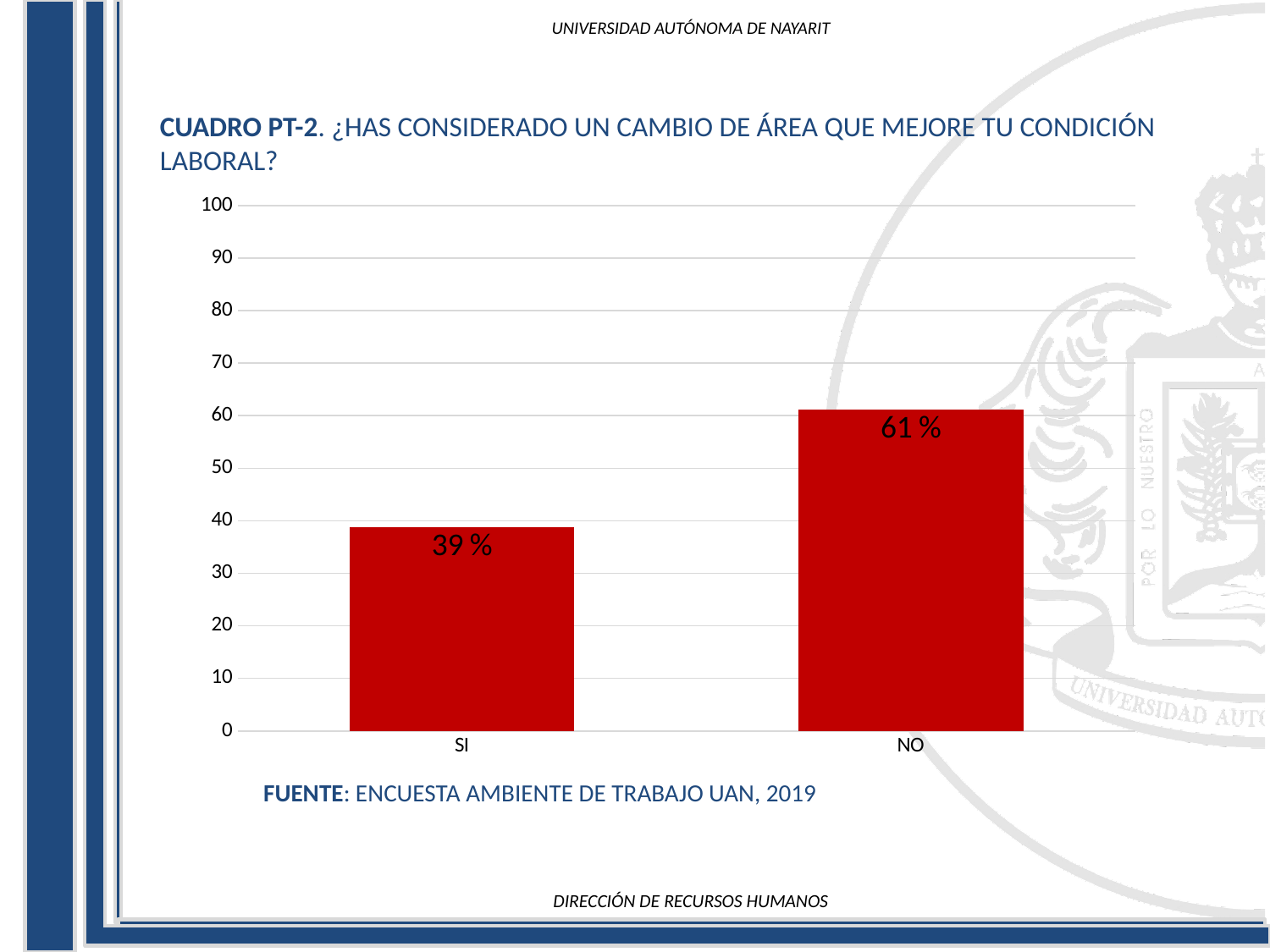
What is the difference between the values for NO and SI? 22 % What is the value for NO? 61 % Which category has the lowest value? SI Which category has the highest value? NO How many categories are shown on the x axis? 2 Which is larger, the value for SI or the value for NO? NO What colour are the bars in the chart? red What is the maximum value shown on the y axis? 100 Is the value for NO greater or less than 50? greater Is the value for SI greater or less than 50? less What is the value for SI? 39 % What kind of chart is shown on the slide? bar chart